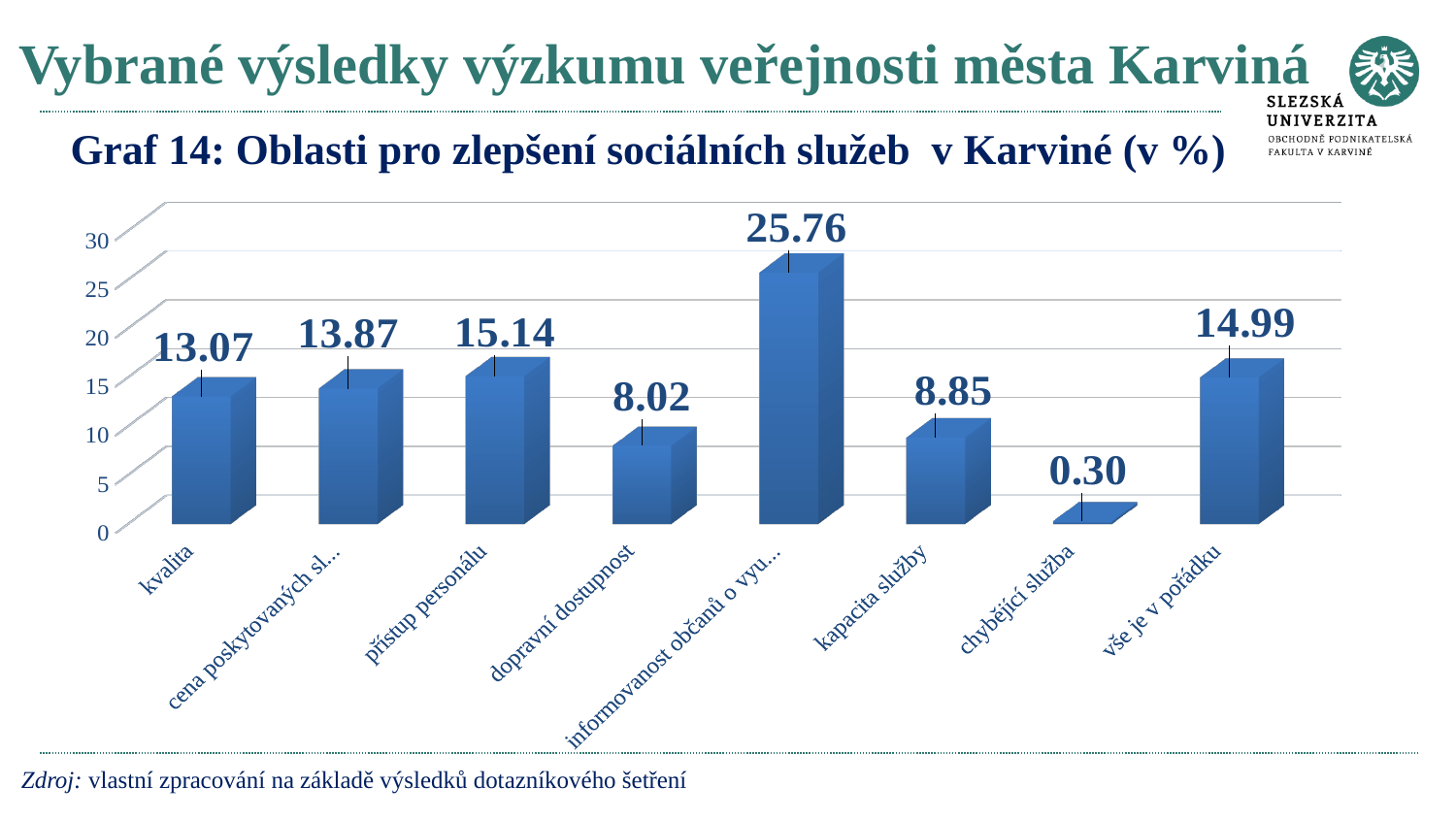
Which category has the highest value? informovanost občanů o vyu... How many categories are shown on the chart? 8 What is the value for dopravní dostupnost? 8.02 Is the value for kapacita služby greater or less than 10? less Which category has the lowest value? chybějící služba What is the value for přístup personálu? 15.14 What is the difference between the values for přístup personálu and kapacita služby? 6.29 What is the title of the chart? Graf 14: Oblasti pro zlepšení sociálních služeb v Karviné (v %) What kind of chart is shown on the slide? bar chart Which is larger, the value for kvalita or the value for vše je v pořádku? vše je v pořádku What is the value for kvalita? 13.07 What is the value for vše je v pořádku? 14.99